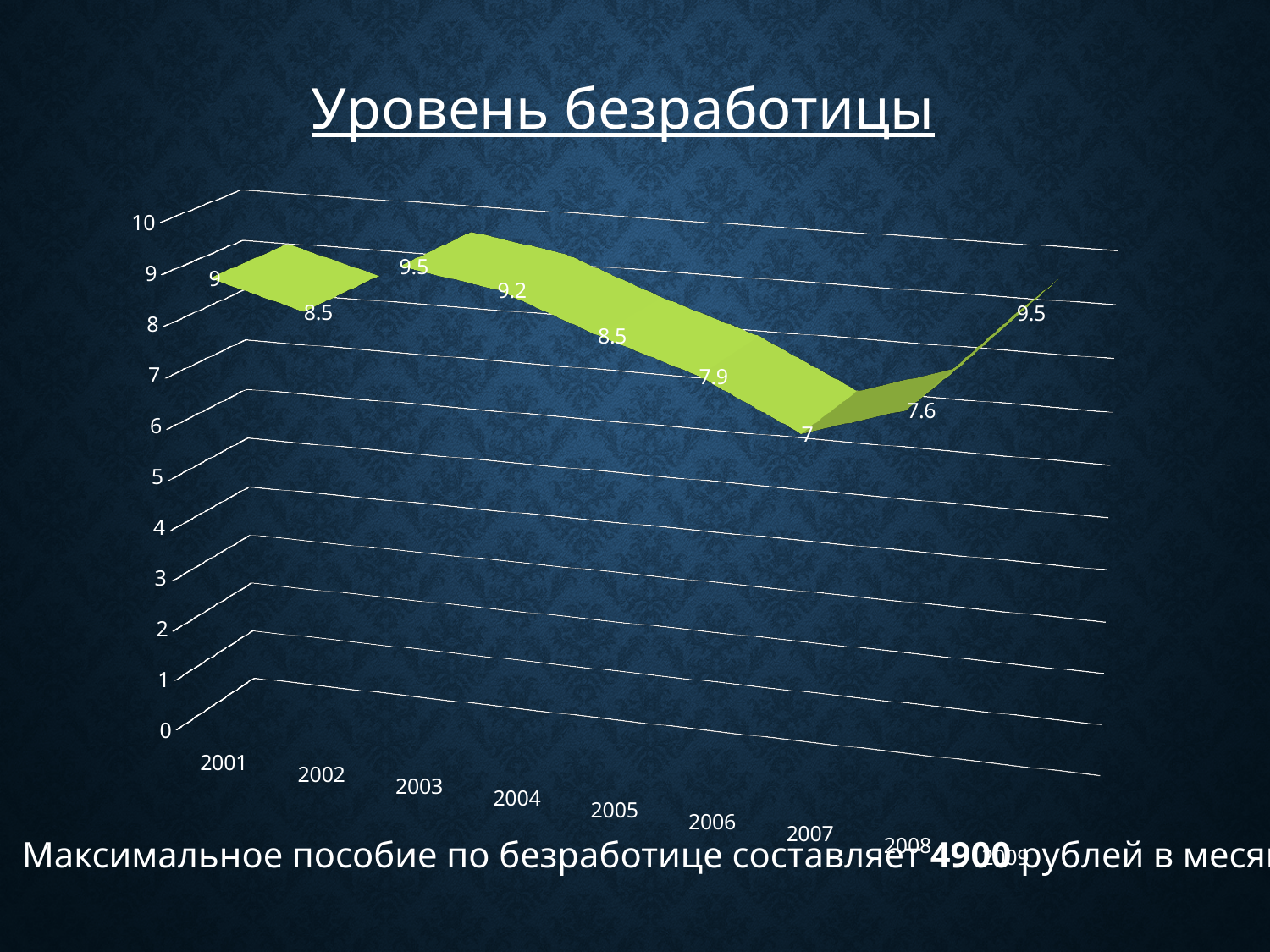
What is the unemployment rate value for 2008? 7.6 Which year has the lowest unemployment rate on the chart? 2007 Is the unemployment rate for 2007 greater or less than 8? less How many years are plotted on the chart? 9 What kind of chart is shown on the slide? line chart What is the difference between the unemployment rate in 2001 and in 2007? 2 What is the unemployment rate value for 2003? 9.5 Which year has a higher unemployment rate, 2002 or 2004? 2004 Does the unemployment rate rise or fall from 2003 to 2007? fall What is the difference between the unemployment rate in 2004 and in 2005? 0.7 What is the unemployment rate value for 2006? 7.9 What is the unemployment rate value for 2001? 9